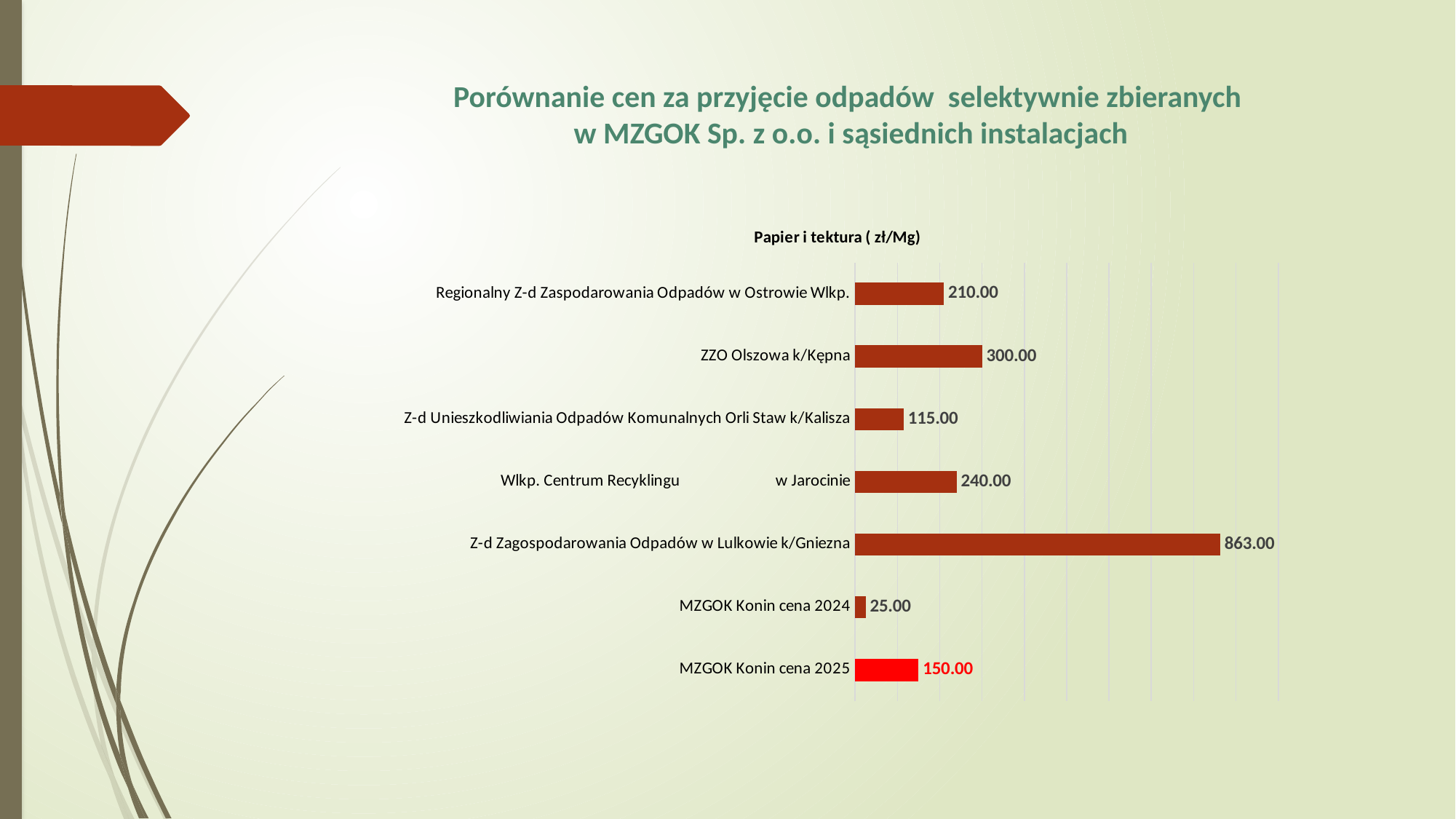
Which category has the lowest value? MZGOK Konin cena 2024 Which is larger: the value for Wlkp. Centrum Recyklingu w Jarocinie or the value for Regionalny Z-d Zaspodarowania Odpadów w Ostrowie Wlkp.? Wlkp. Centrum Recyklingu w Jarocinie What kind of chart is shown on the slide? Bar chart What is the value for MZGOK Konin cena 2025? 150.00 What is the difference between the values for MZGOK Konin cena 2025 and MZGOK Konin cena 2024? 125.00 What is the difference between the values for ZZO Olszowa k/Kępna and Regionalny Z-d Zaspodarowania Odpadów w Ostrowie Wlkp.? 90.00 What is the value for Z-d Unieszkodliwiania Odpadów Komunalnych Orli Staw k/Kalisza? 115.00 How many categories are shown in the chart? 7 What is the value for ZZO Olszowa k/Kępna? 300.00 Which bar is drawn in a different (bright red) colour from the others? MZGOK Konin cena 2025 Which category has the highest value? Z-d Zagospodarowania Odpadów w Lulkowie k/Gniezna What is the title of the chart? Papier i tektura ( zł/Mg)